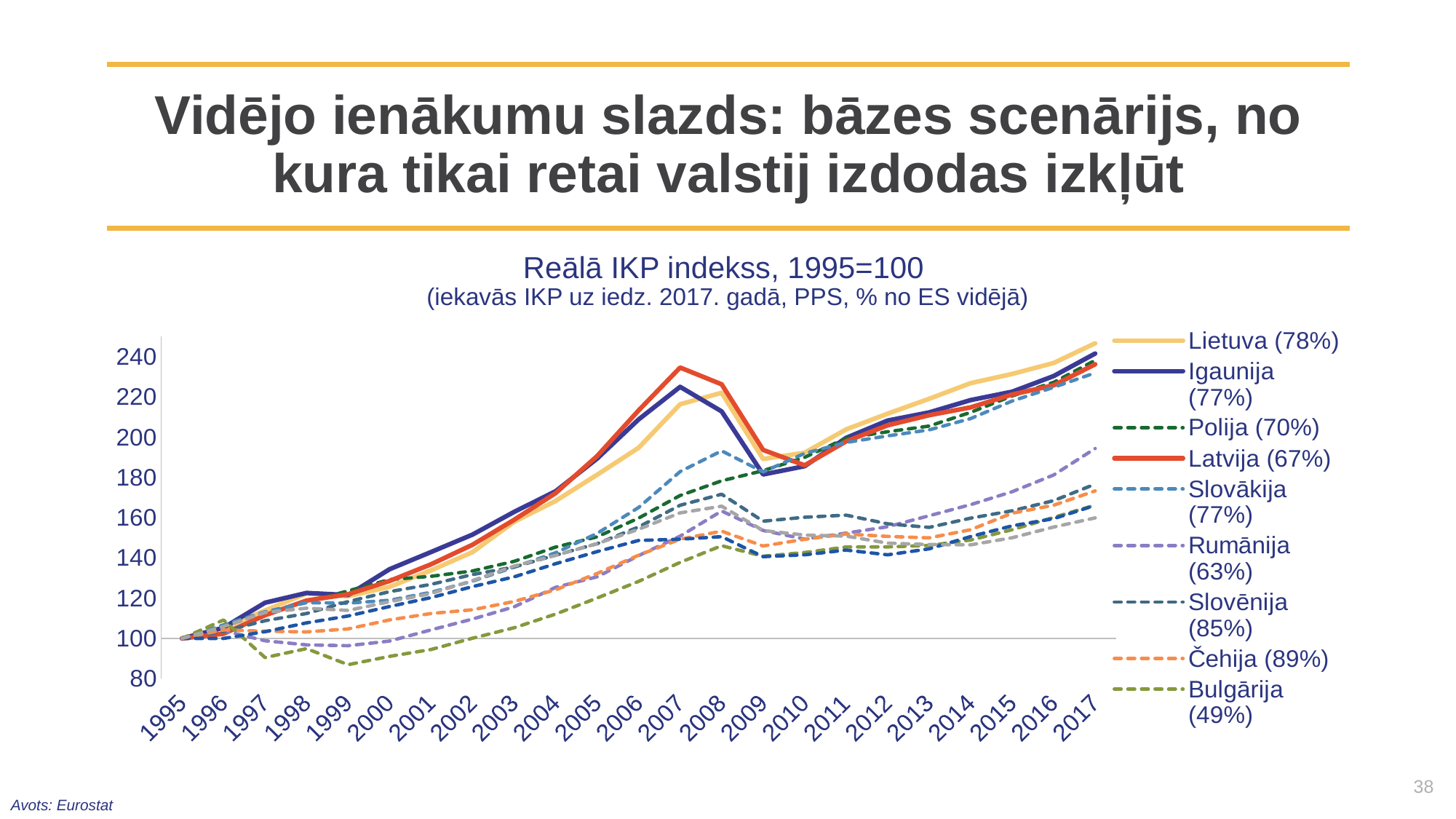
What kind of chart is shown on the slide? line chart What is the value for Lietuva in 1995? 100 What percentage is shown in the legend next to Čehija? 89% How many years are shown along the x axis? 23 Does the value for Lietuva rise or fall from 2009 to 2017? rise Is the value for Rumānija in 2017 greater or less than 180? greater Is the value for Latvija in 2007 greater or less than 220? greater Is the value for Bulgārija in 1999 greater or less than 100? less In 2007, which is larger: the value for Latvija or the value for Bulgārija? Latvija Which series reaches the highest value in 2007? Latvija How many series does the legend list? 9